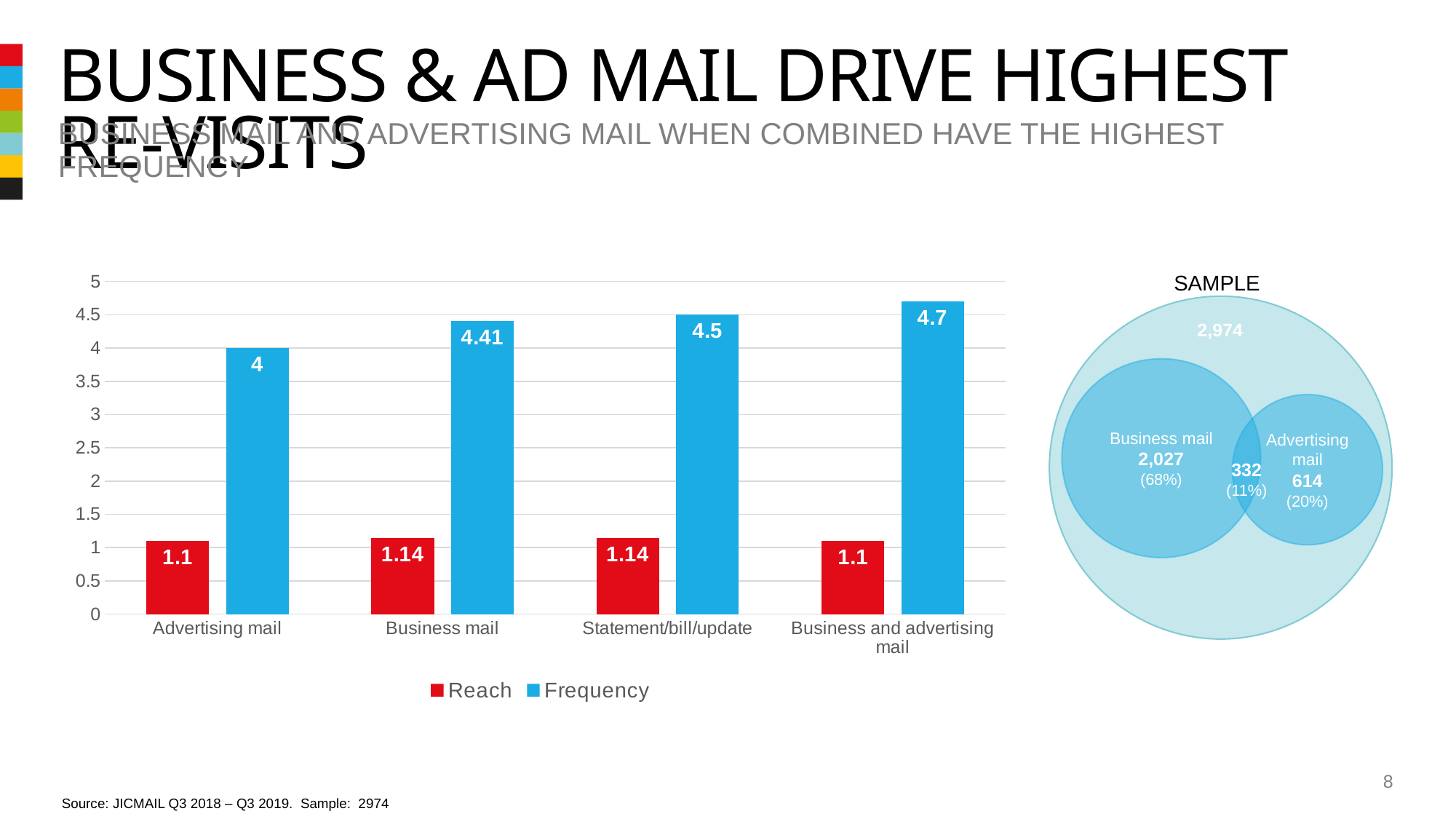
How many categories are shown on the x axis of the bar chart? 4 In the bar chart, which category has the lowest Frequency? Advertising mail In the bar chart, which category has the highest Frequency? Business and advertising mail In the bar chart, what is the Frequency value for Business mail? 4.41 In the bar chart, what is the difference between the Frequency for Business and advertising mail and the Frequency for Advertising mail? 0.7 In the bar chart, what is the Frequency value for Business and advertising mail? 4.7 In the bar chart, which colour represents the Frequency series? Blue How many series does the legend of the bar chart list? 2 In the bar chart, is the Reach value for Advertising mail greater or less than 2? less What kind of chart is the chart on the left of the slide? Bar chart In the bar chart, what is the Reach value for Statement/bill/update? 1.14 In the bar chart, which is larger: the Frequency for Statement/bill/update or the Frequency for Advertising mail? Statement/bill/update